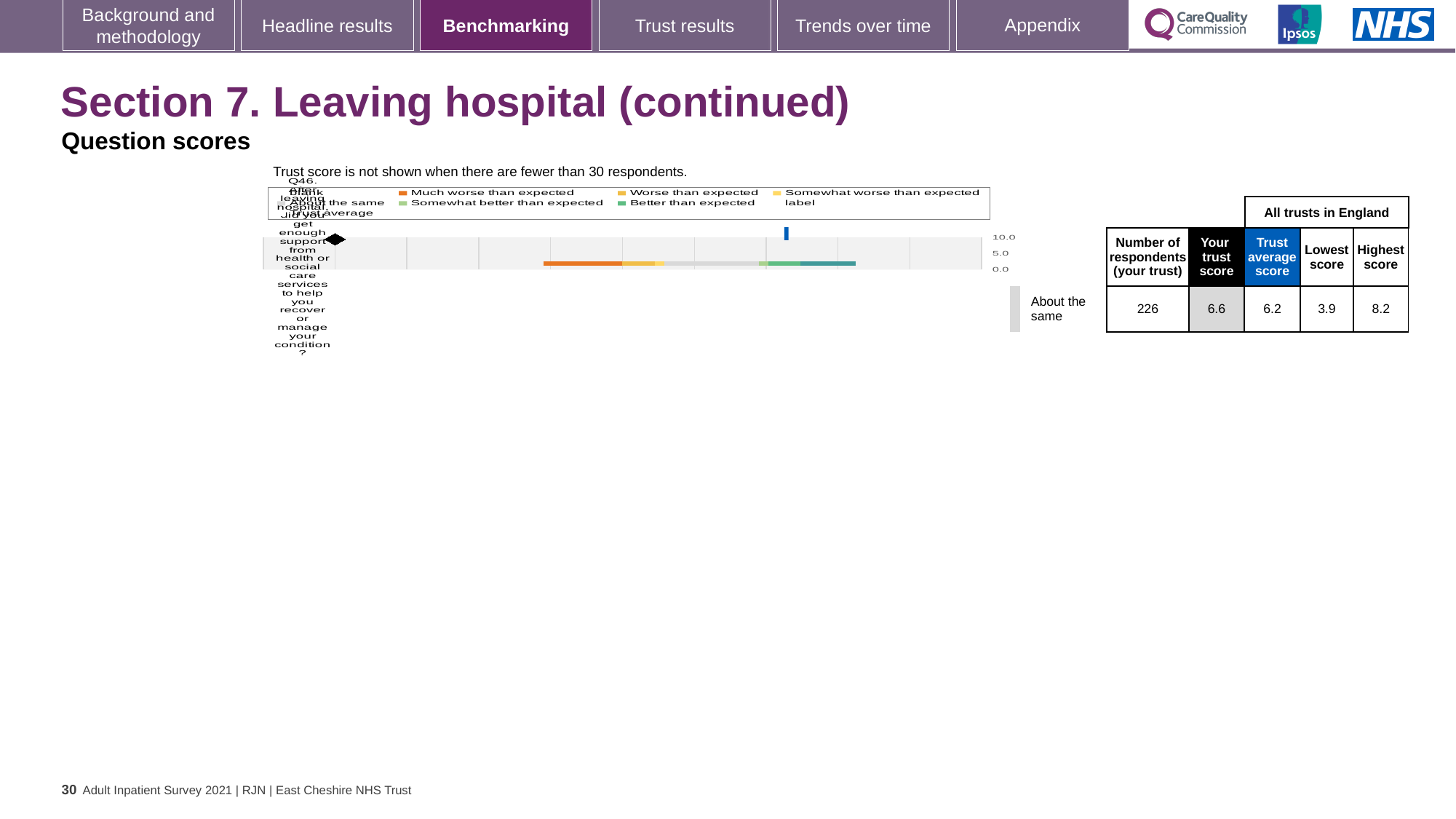
Which is larger for Q46: the trust's score or the trust average score? the trust's score What is the highest score for Q46 among all trusts in England? 8.2 What is the difference between the highest and lowest scores for Q46 across all trusts in England? 4.3 What is the trust average score for Q46 across all trusts in England? 6.2 What benchmark category is the trust's Q46 result placed in? About the same What is the lowest score for Q46 among all trusts in England? 3.9 How many questions are plotted on the benchmarking chart? 1 How many respondents from the trust answered Q46? 226 Which legend entry is shown in orange on the benchmarking chart? Much worse than expected What is the trust's score for Q46 shown in the table? 6.6 What type of chart is used to show the Q46 benchmarking result? bar chart What is the difference between the trust's score and the trust average score for Q46? 0.4